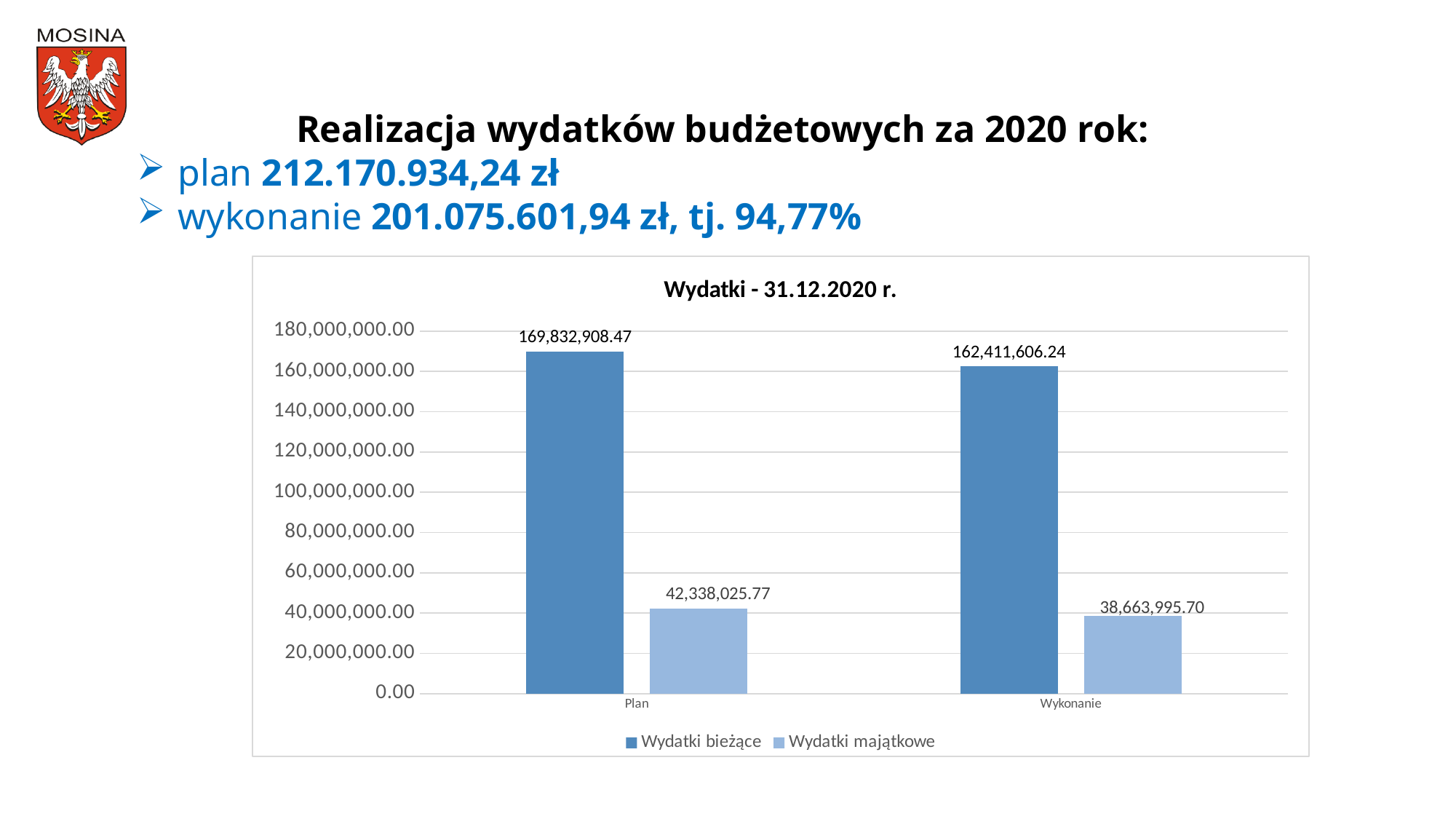
What is the difference between Wydatki bieżące for Plan and Wydatki bieżące for Wykonanie? 7,421,302.23 What is the value of Wydatki bieżące for Wykonanie? 162,411,606.24 What type of chart is shown on the slide? Bar chart What is the value of Wydatki majątkowe for Wykonanie? 38,663,995.70 What is the difference between Wydatki majątkowe for Plan and Wydatki majątkowe for Wykonanie? 3,674,030.07 How many categories are shown on the x axis of the chart? 2 What is the value of Wydatki majątkowe for Plan? 42,338,025.77 What is the value of Wydatki bieżące for Plan? 169,832,908.47 Which bar in the chart has the lowest value? Wydatki majątkowe for Wykonanie Which bar in the chart has the highest value? Wydatki bieżące for Plan Which is larger: Wydatki majątkowe for Plan or Wydatki majątkowe for Wykonanie? Wydatki majątkowe for Plan How many series does the chart legend list? 2